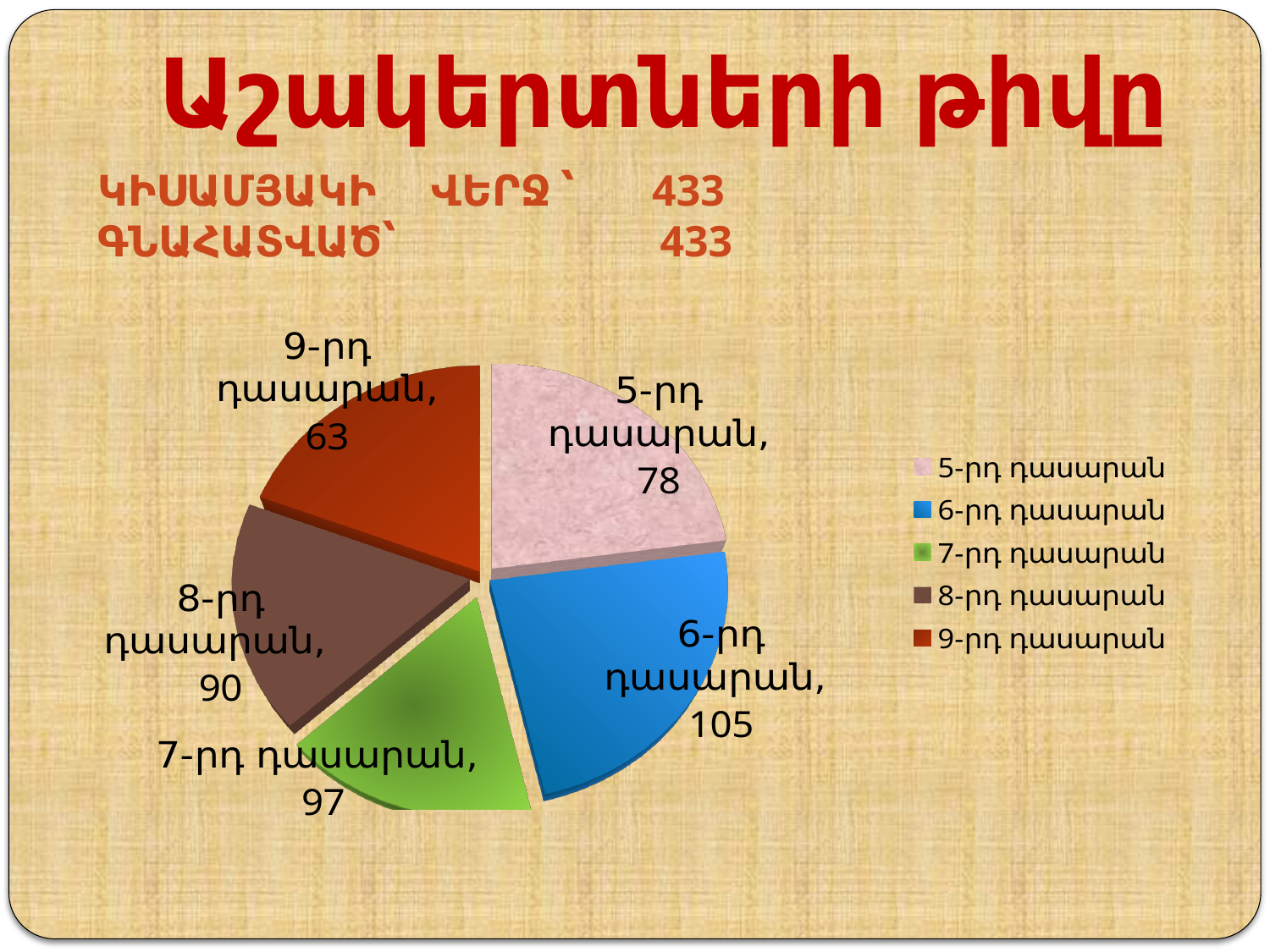
Which is larger, the value for 7-րդ դասարան or 8-րդ դասարան? 7-րդ դասարան What is the total of all slices in the pie chart? 433 What is the value for 8-րդ դասարան? 90 What colour is the slice for 6-րդ դասարան? blue Which class has the largest slice of the pie? 6-րդ դասարան How many entries does the legend list? 5 What is the value for 6-րդ դասարան? 105 What is the value for 9-րդ դասարան? 63 How many slices does the pie chart have? 5 What type of chart is shown on the slide? pie chart What is the difference between the values for 6-րդ դասարան and 5-րդ դասարան? 27